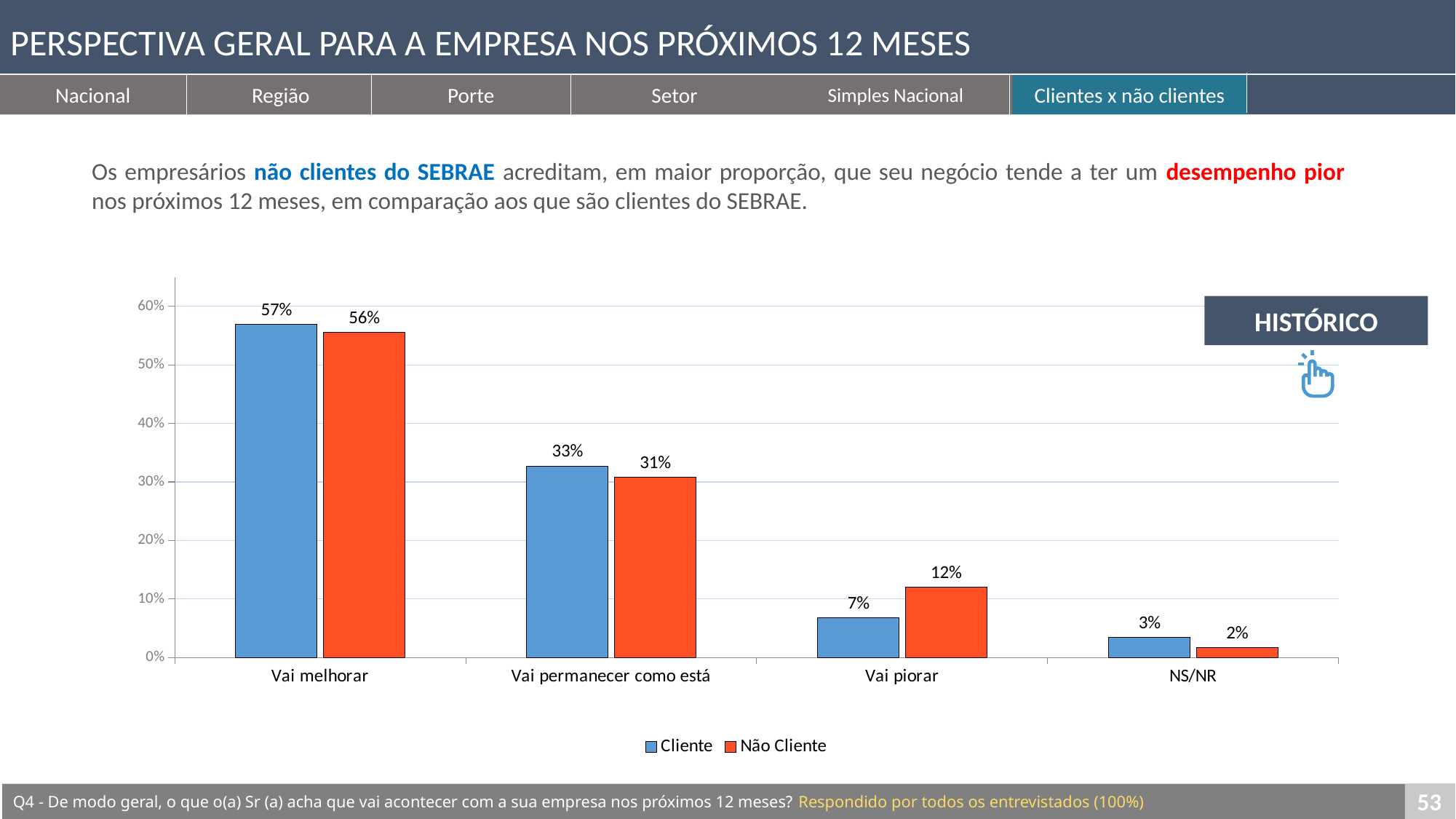
What is the difference between the Não Cliente and Cliente values in the 'Vai piorar' category? 5% What is the value for Não Cliente in the 'Vai piorar' category? 12% Which category has the highest value for the Cliente series? Vai melhorar In the 'Vai piorar' category, which series has the larger value, Cliente or Não Cliente? Não Cliente What colour represents the Não Cliente series in the chart? Red/orange What is the value for Cliente in the 'NS/NR' category? 3% What kind of chart is shown on the slide? Bar chart How many series does the legend list? 2 How many categories are shown on the x axis of the chart? 4 What is the value for Não Cliente in the 'Vai permanecer como está' category? 31% Which category has the lowest value for the Não Cliente series? NS/NR What is the value for Cliente in the 'Vai melhorar' category? 57%